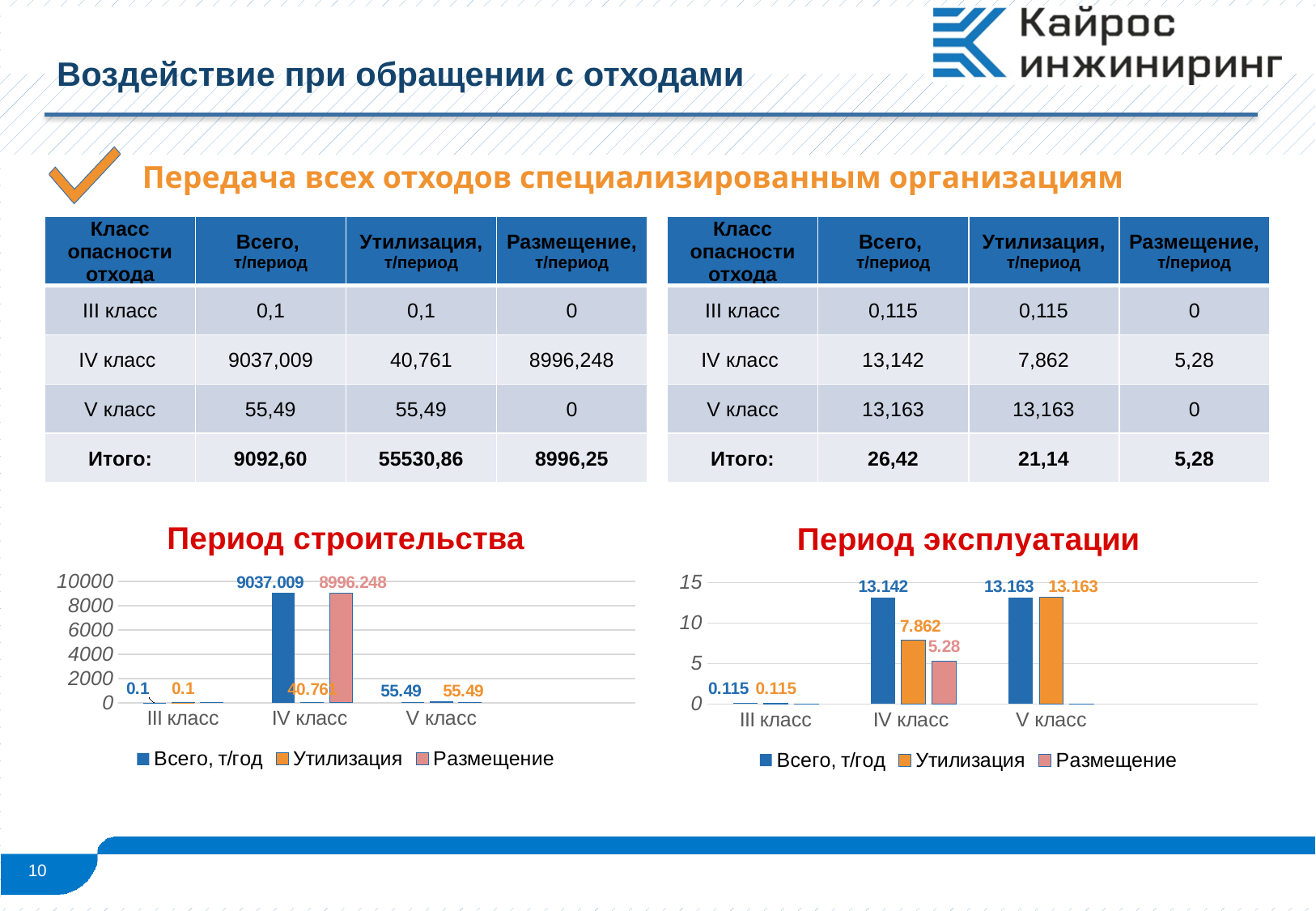
In the 'Период строительства' chart, which category has the highest 'Всего, т/год' value? IV класс In the 'Период строительства' chart, what is the value of 'Размещение' for IV класс? 8996.248 In the 'Период строительства' chart, what is the difference between 'Всего, т/год' and 'Утилизация' for IV класс? 8996.248 What type of chart is 'Период строительства'? Bar chart In the 'Период эксплуатации' chart, what is the value of 'Размещение' for IV класс? 5.28 In the 'Период эксплуатации' chart, which category has the lowest 'Всего, т/год' value? III класс In the 'Период эксплуатации' chart, which is larger for IV класс: 'Утилизация' or 'Размещение'? Утилизация In the 'Период строительства' chart, what is the value of 'Утилизация' for V класс? 55.49 In the 'Период строительства' chart, what is the value of 'Всего, т/год' for IV класс? 9037.009 In the 'Период эксплуатации' chart, is 'Всего, т/год' for V класс greater or less than 10? greater In the 'Период эксплуатации' chart, what is the value of 'Утилизация' for IV класс? 7.862 How many series does the legend of the 'Период эксплуатации' chart list? 3